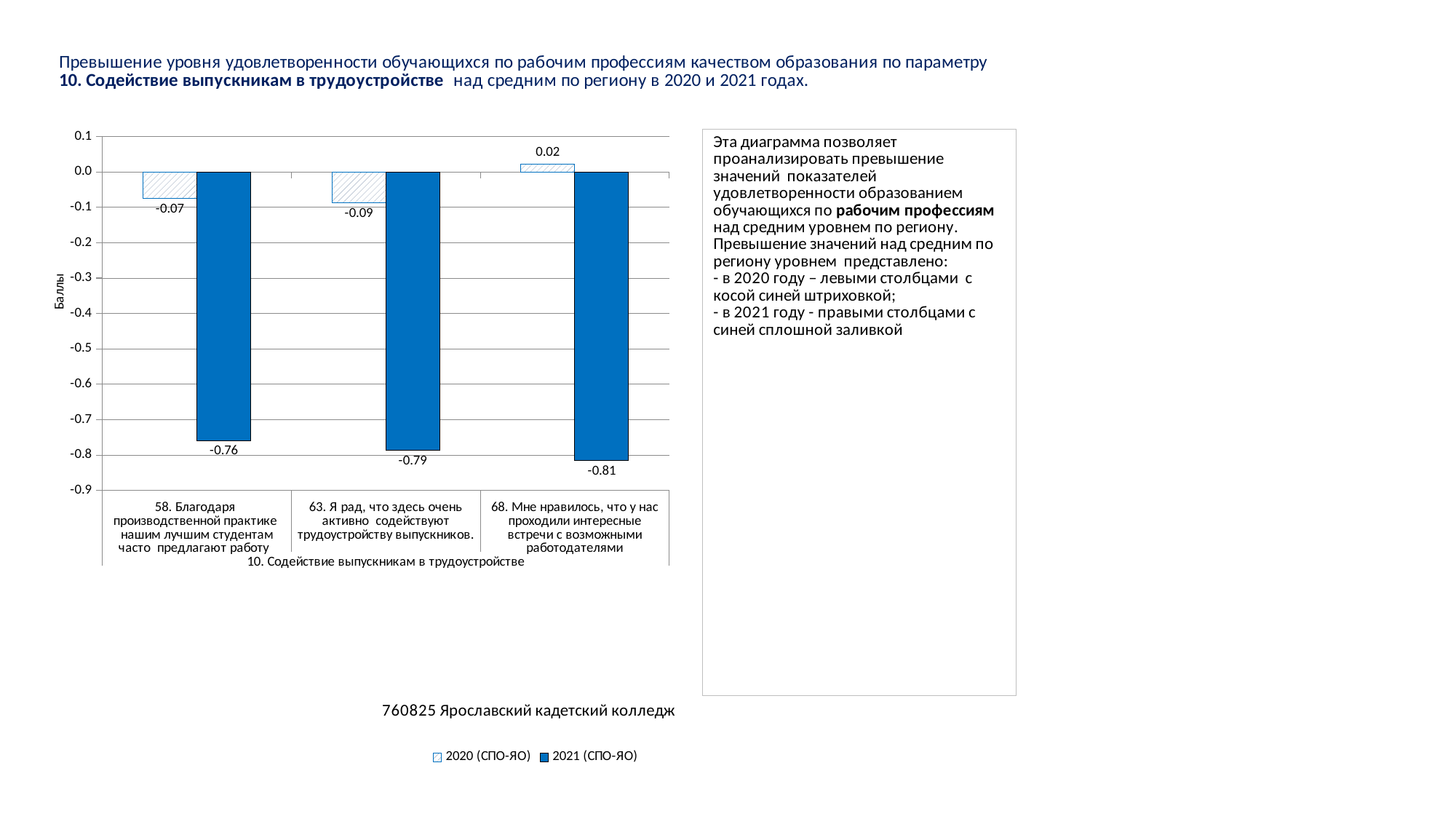
What is the label of the chart's y axis? Баллы Which category has the lowest 2021 (СПО-ЯО) value? 68. Мне нравилось, что у нас проходили интересные встречи с возможными работодателями What is the 2021 (СПО-ЯО) value for category 68? -0.81 What is the 2021 (СПО-ЯО) value for category 58 (Благодаря производственной практике нашим лучшим студентам часто предлагают работу)? -0.76 Which category has the highest 2020 (СПО-ЯО) value? 68. Мне нравилось, что у нас проходили интересные встречи с возможными работодателями What is the difference between the 2020 and 2021 values for category 58? 0.69 What is the 2020 (СПО-ЯО) value for category 63 (Я рад, что здесь очень активно содействуют трудоустройству выпускников)? -0.09 How many categories (questions) are shown on the x axis of the chart? 3 What is the 2020 (СПО-ЯО) value for category 68 (Мне нравилось, что у нас проходили интересные встречи с возможными работодателями)? 0.02 What type of chart is shown on the slide? bar chart How many series does the chart legend list? 2 Which is larger for category 63: the 2020 (СПО-ЯО) value or the 2021 (СПО-ЯО) value? 2020 (СПО-ЯО)